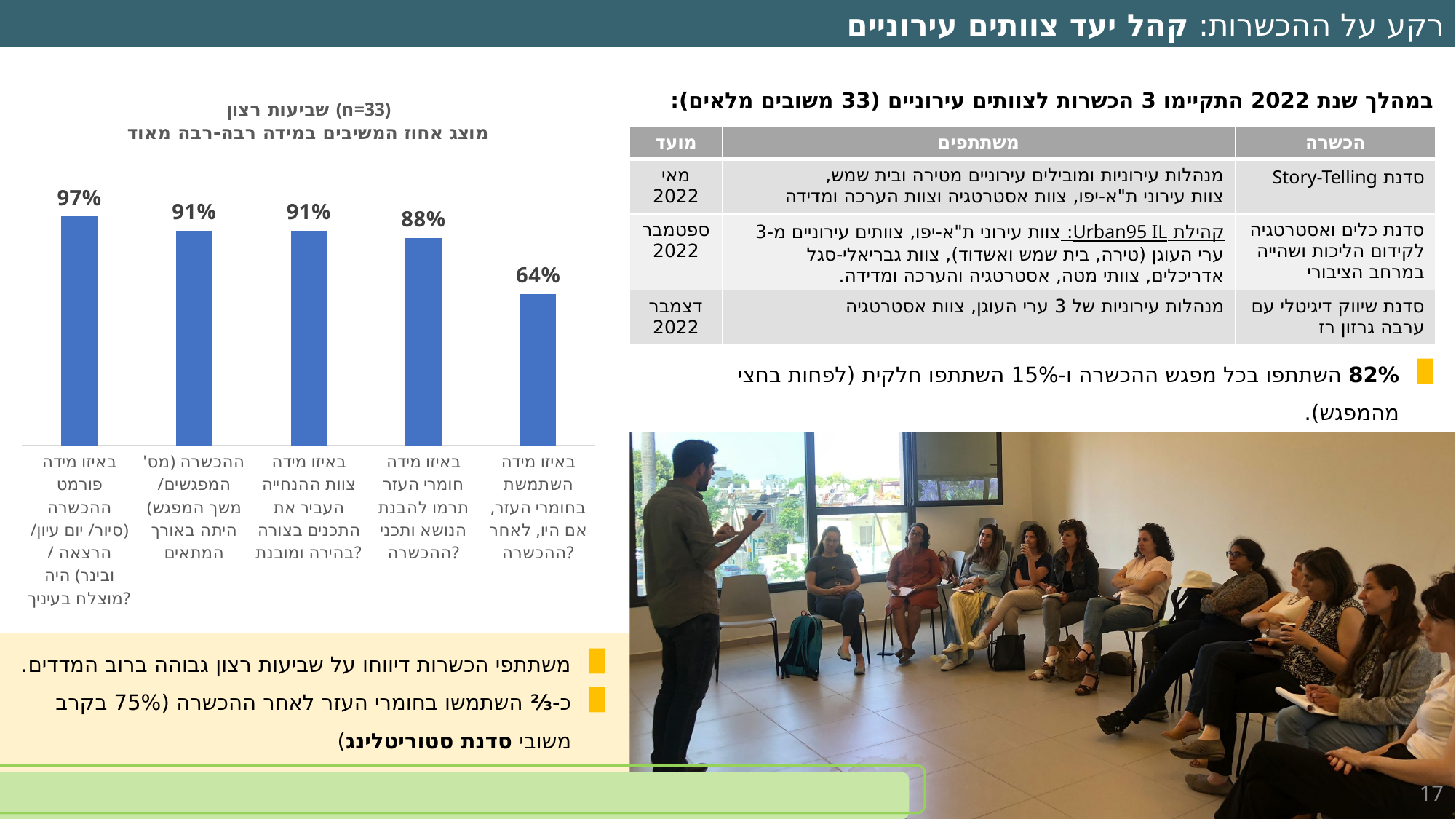
Which category has the highest value in the chart? באיזו מידה פורמט ההכשרה (סיור/ יום עיון/ הרצאה / ובינר) היה מוצלח בעיניך? What is the sample size (n) stated in the chart title? n=33 What type of chart is shown on the slide? bar chart Which is larger: the value for 'באיזו מידה חומרי העזר תרמו להבנת הנושא ותכני ההכשרה?' or the value for 'באיזו מידה השתמשת בחומרי העזר, אם היו, לאחר ההכשרה?'? באיזו מידה חומרי העזר תרמו להבנת הנושא ותכני ההכשרה? How many bars (categories) does the chart show? 5 What is the value for the category 'ההכשרה (מס' המפגשים/ משך המפגש) היתה באורך המתאים'? 91% What colour are the bars in the chart? blue What is the value for the category 'באיזו מידה פורמט ההכשרה (סיור/ יום עיון/ הרצאה / ובינר) היה מוצלח בעיניך?'? 97% What is the value for the category 'באיזו מידה חומרי העזר תרמו להבנת הנושא ותכני ההכשרה?'? 88% What is the value for the category 'באיזו מידה השתמשת בחומרי העזר, אם היו, לאחר ההכשרה?'? 64% Which category has the lowest value in the chart? באיזו מידה השתמשת בחומרי העזר, אם היו, לאחר ההכשרה? What is the difference between the highest value (97%) and the lowest value (64%) in the chart? 33%